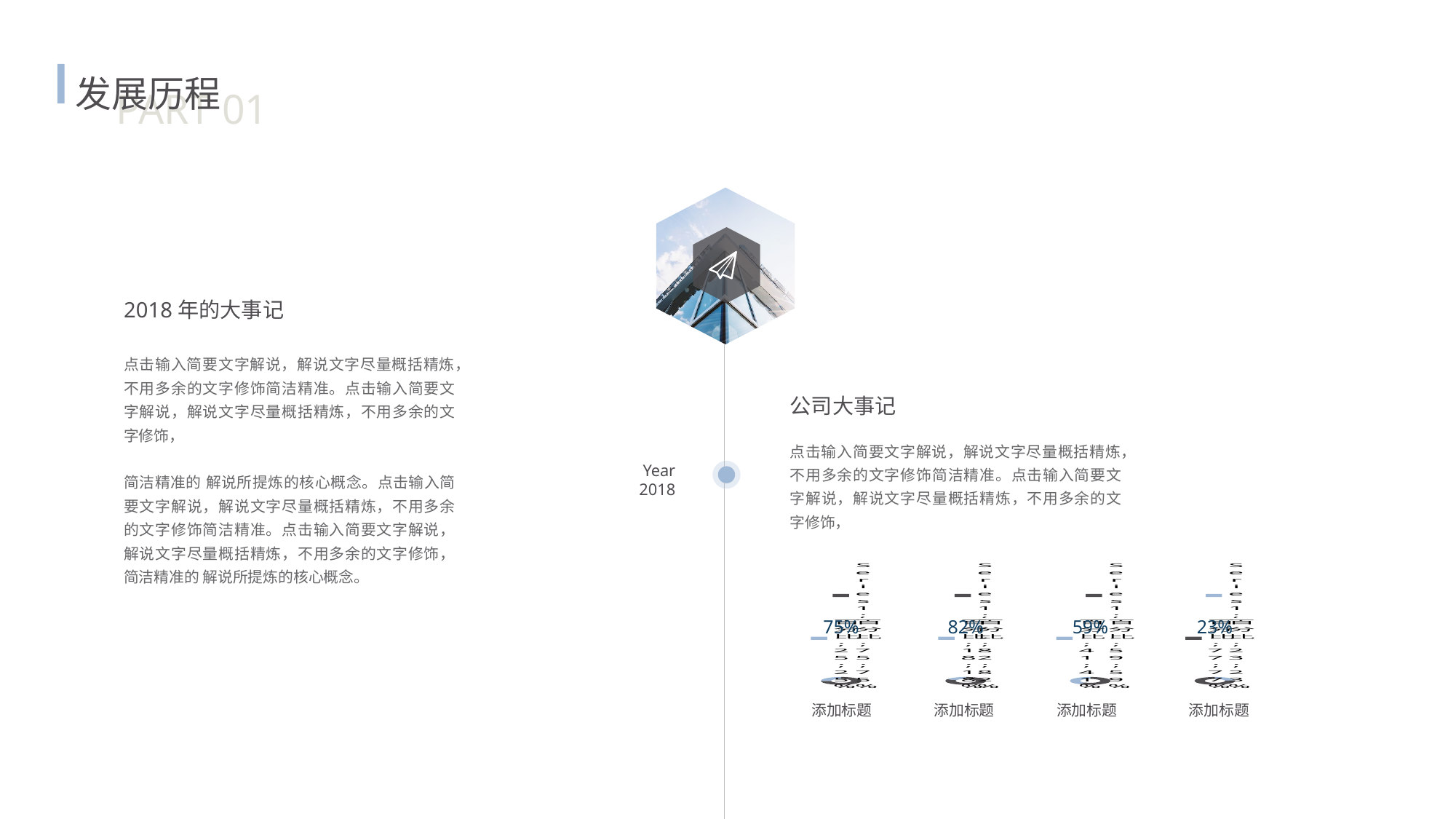
What caption appears under each of the four small charts at the bottom right? 添加标题 How many small charts are shown at the bottom right of the slide? 4 Which is larger: the percentage on the third chart from the left or the rightmost chart? The third chart from the left (59%) Among the four small charts at the bottom right, which one shows the highest percentage? The second from the left (82%) What percentage is shown on the rightmost chart at the bottom right of the slide? 23% What percentage is shown on the leftmost chart at the bottom right of the slide? 75% Among the four small charts at the bottom right, which one shows the lowest percentage? The rightmost (23%) What is the difference between the percentage on the second chart from the left (82%) and the leftmost chart (75%)? 7% What percentage is shown on the third chart from the left at the bottom right of the slide? 59% What percentage is shown on the second chart from the left at the bottom right of the slide? 82%